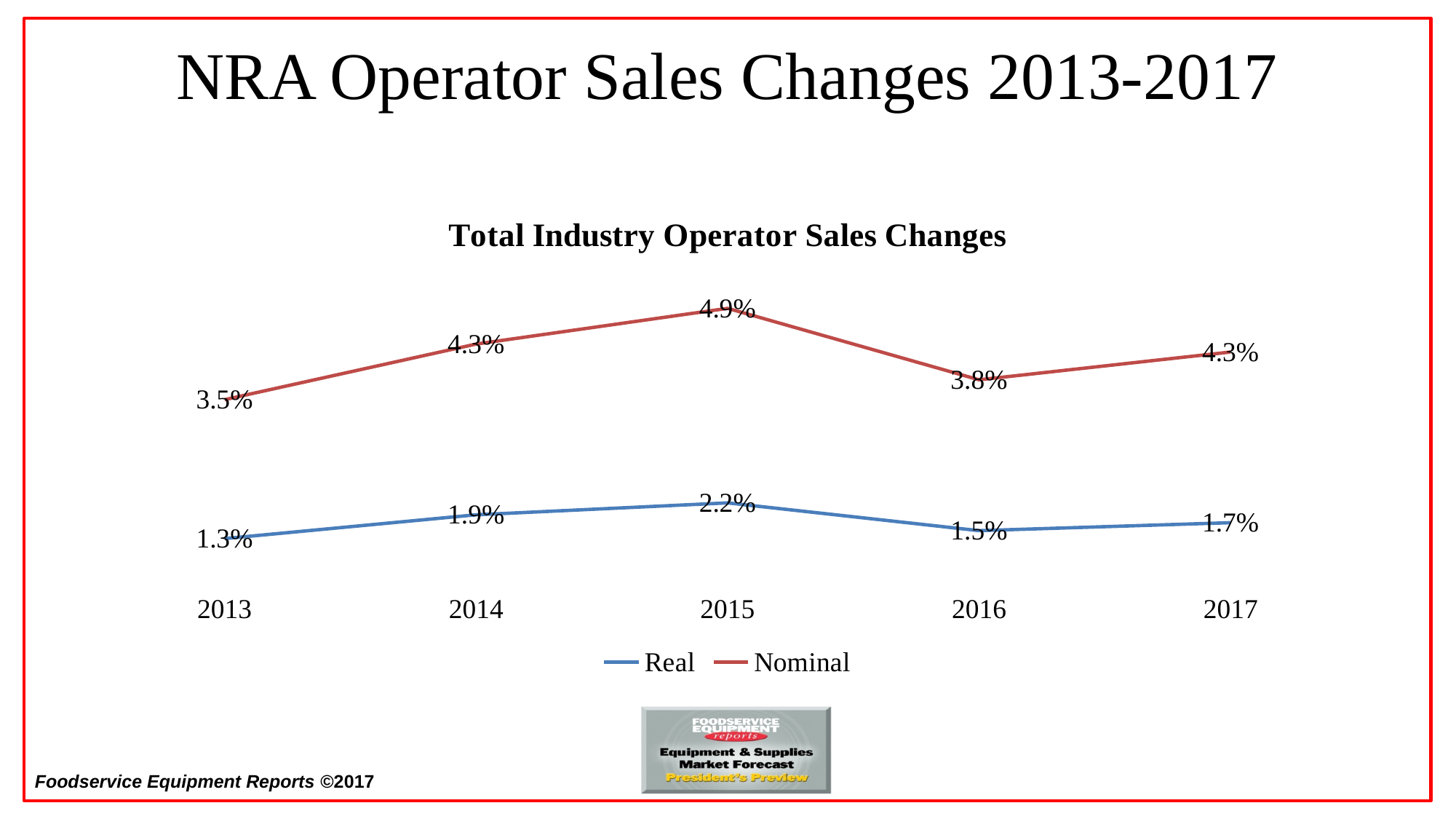
In which year is the Real series lowest? 2013 Which is larger in 2014, the Real value or the Nominal value? Nominal What is the title of the chart? Total Industry Operator Sales Changes What is the difference between the Nominal and Real values in 2015? 2.7% How many years are shown on the x axis? 5 What is the Nominal value for 2015? 4.9% What is the Real value for 2013? 1.3% What kind of chart is shown? Line chart What is the Real value for 2016? 1.5% In which year is the Nominal series highest? 2015 What is the Nominal value for 2017? 4.3% How many series does the legend list? 2